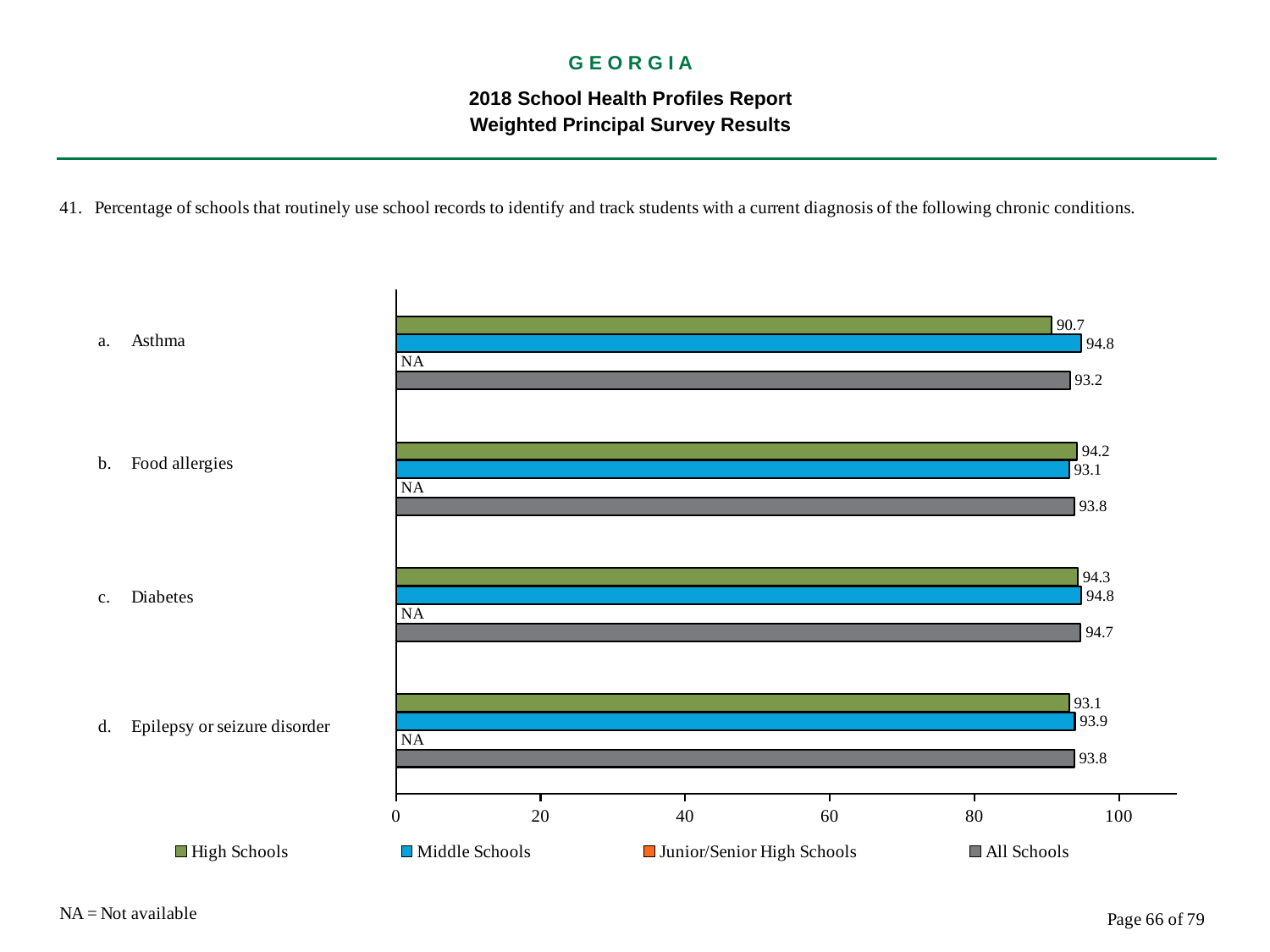
What kind of chart is shown on the slide? bar chart How many series does the legend list? 4 How many chronic conditions are listed on the chart? 4 What is the value for Middle Schools for Diabetes? 94.8 Which condition has the lowest value for High Schools? Asthma Is the value for All Schools for Epilepsy or seizure disorder greater or less than 80? greater What is the value for High Schools for Asthma? 90.7 Which condition has the highest value for All Schools? Diabetes What is the difference between the Middle Schools and High Schools values for Asthma? 4.1 What is the value for All Schools for Food allergies? 93.8 Which is larger for Food allergies: the High Schools value or the Middle Schools value? High Schools What is the value for Junior/Senior High Schools for Epilepsy or seizure disorder? NA